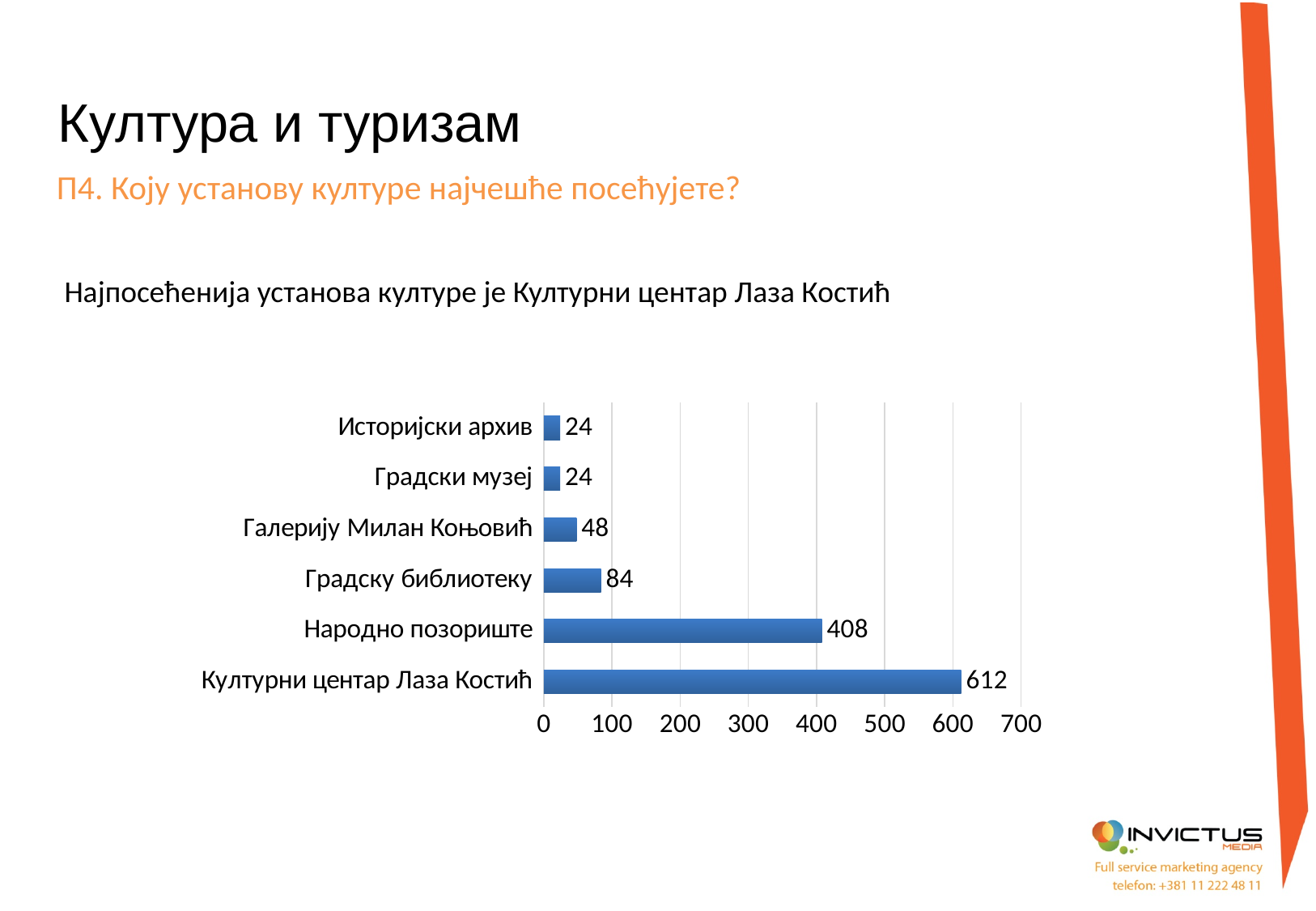
Is the value for Народно позориште greater or less than 500? less Which is larger, the value for Народно позориште or the value for Градску библиотеку? Народно позориште What is the value for Галерију Милан Коњовић? 48 What is the value for Културни центар Лаза Костић? 612 What is the value for Народно позориште? 408 What is the difference between the values for Градску библиотеку and Галерију Милан Коњовић? 36 What is the maximum value shown on the horizontal axis? 700 What is the value for Градску библиотеку? 84 What is the difference between the values for Културни центар Лаза Костић and Народно позориште? 204 Which category has the highest value? Културни центар Лаза Костић How many categories are shown in the chart? 6 What kind of chart is shown on the slide? bar chart